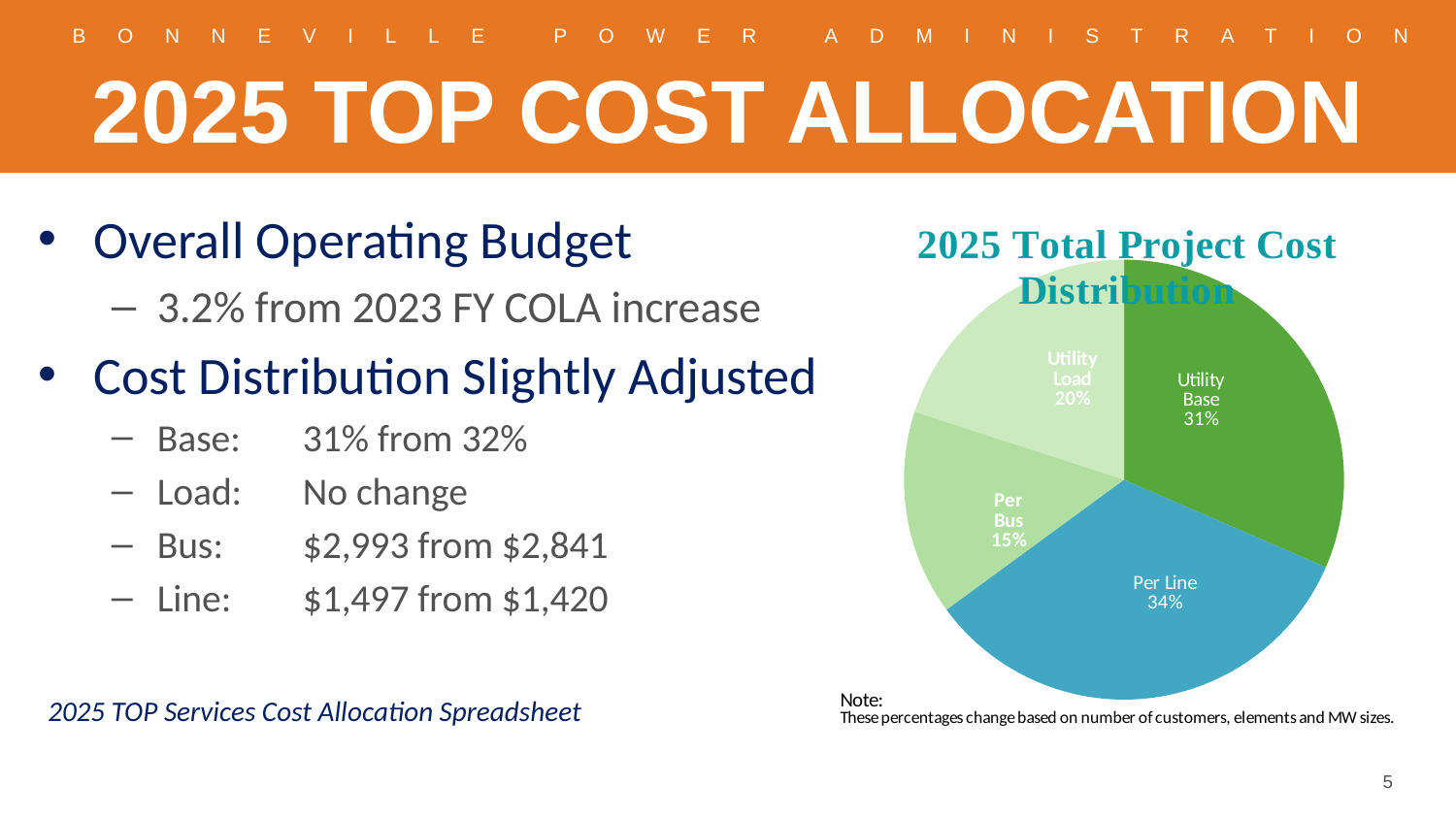
What is the title of the chart? 2025 Total Project Cost Distribution Which slice of the pie is the largest? Per Line What is the combined share of Utility Base and Utility Load? 51% Which slice of the pie is the smallest? Per Bus What is the difference in percentage points between Per Line and Per Bus? 19 What share of the pie does Utility Base represent? 31% Which is larger, Utility Base or Utility Load? Utility Base What share of the pie does Utility Load represent? 20% What kind of chart is shown on the slide? pie chart What share of the pie does Per Bus represent? 15% How many slices does the pie chart have? 4